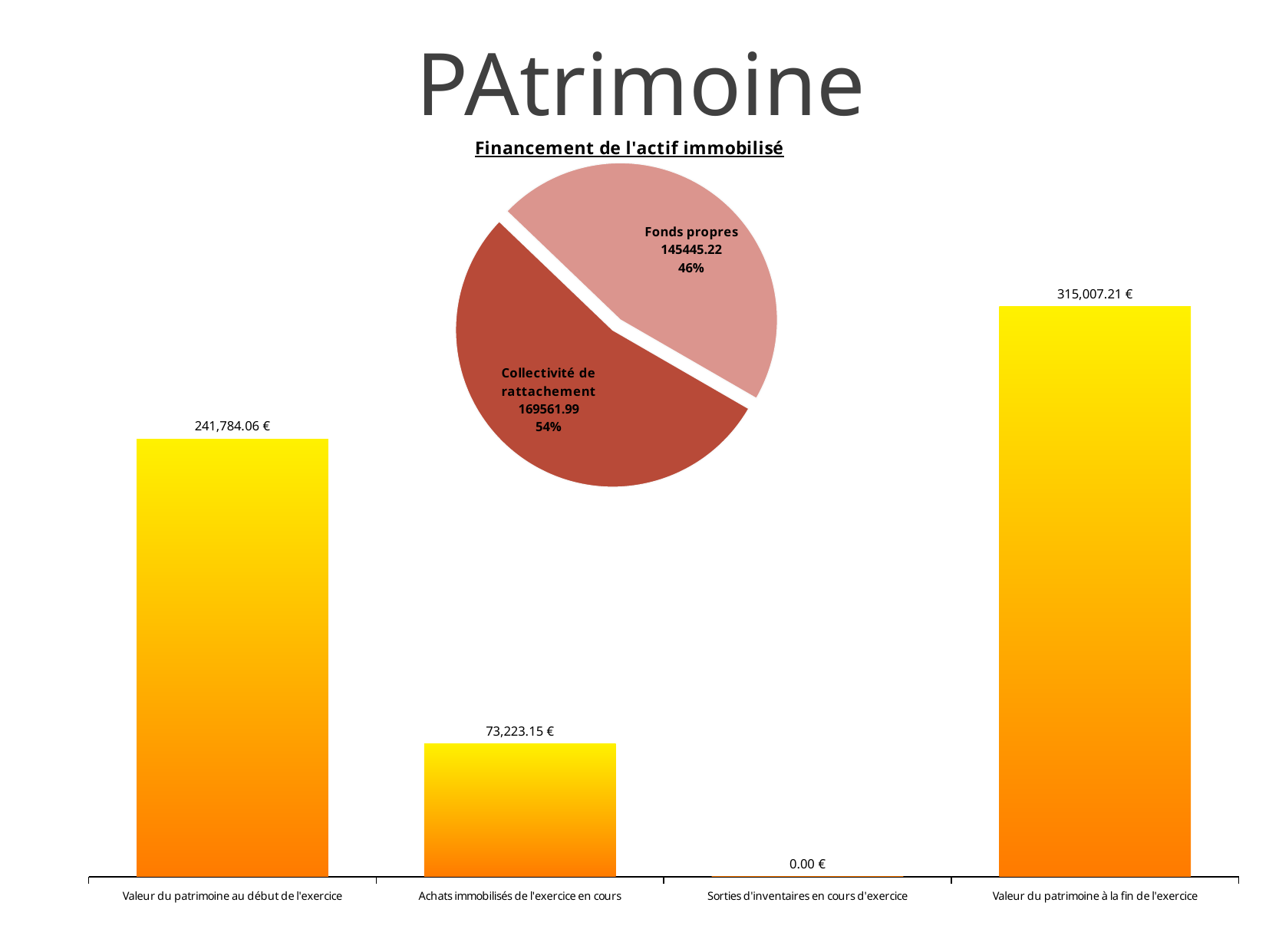
In the pie chart 'Financement de l'actif immobilisé', what share does 'Collectivité de rattachement' represent? 54% In the pie chart 'Financement de l'actif immobilisé', what is the value for 'Fonds propres'? 145445.22 In the bar chart, what is the difference between 'Valeur du patrimoine à la fin de l'exercice' and 'Valeur du patrimoine au début de l'exercice'? 73,223.15 € In the bar chart, what is the value for 'Achats immobilisés de l'exercice en cours'? 73,223.15 € What kind of chart is the chart at the bottom of the slide? bar chart In the pie chart 'Financement de l'actif immobilisé', which slice is larger, 'Fonds propres' or 'Collectivité de rattachement'? Collectivité de rattachement In the pie chart 'Financement de l'actif immobilisé', what is the difference between 'Collectivité de rattachement' and 'Fonds propres'? 24116.77 In the bar chart, what is the value for 'Sorties d'inventaires en cours d'exercice'? 0.00 € In the bar chart, how many categories are shown? 4 In the bar chart, which category has the lowest value? Sorties d'inventaires en cours d'exercice In the bar chart, which category has the highest value? Valeur du patrimoine à la fin de l'exercice In the bar chart, what is the value for 'Valeur du patrimoine au début de l'exercice'? 241,784.06 €